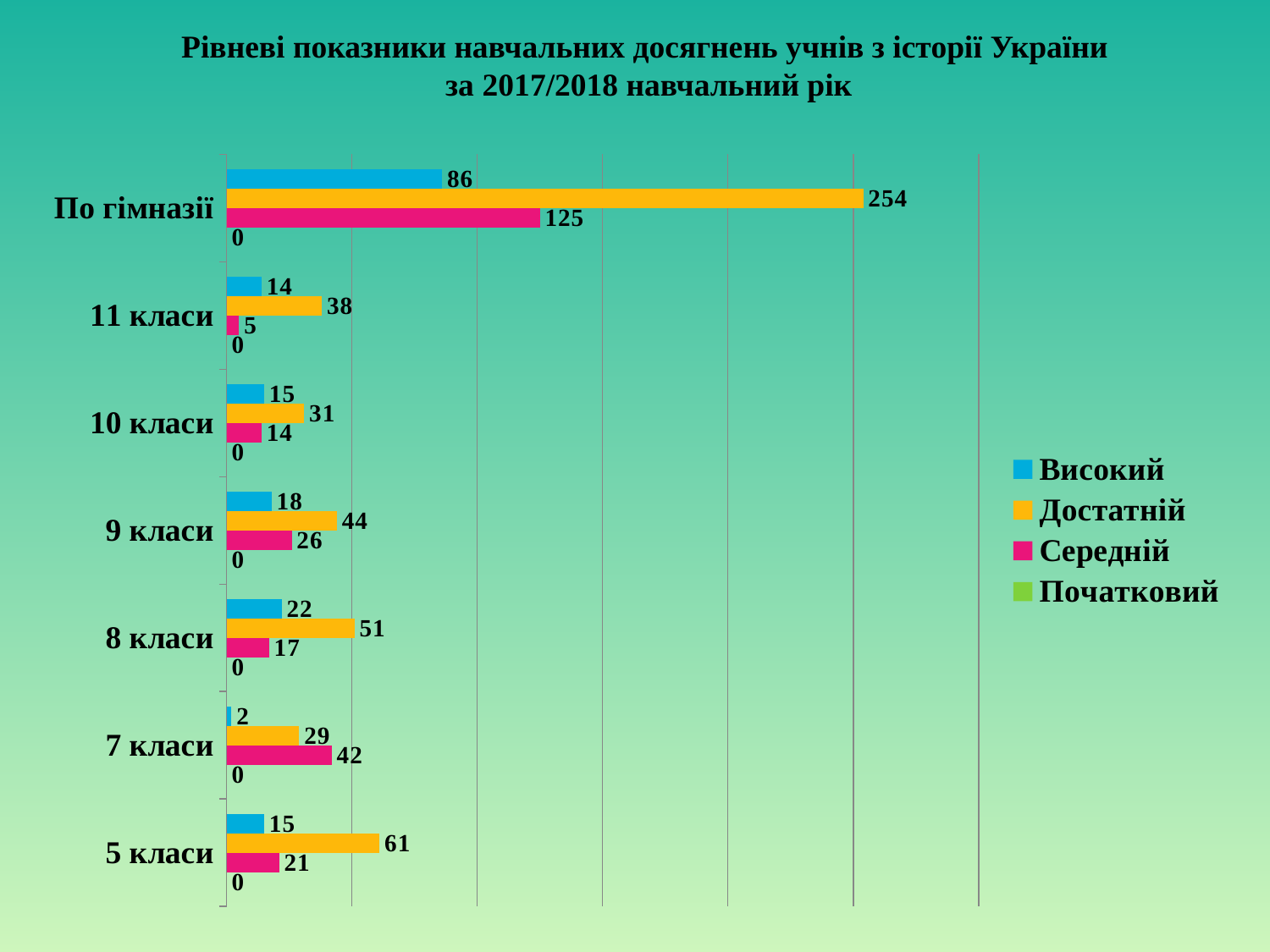
How many series does the legend list? 4 What is the value of Достатній for По гімназії? 254 What is the value of Високий for 8 класи? 22 Which colour represents the Середній series in the legend? pink How many categories are shown on the vertical axis? 7 What kind of chart is shown on the slide? bar chart Which class category has the highest Достатній value, excluding По гімназії? 5 класи What is the value of Початковий for 5 класи? 0 Which is larger for 7 класи: Достатній or Середній? Середній What is the difference between the Достатній and Середній values for По гімназії? 129 What is the value of Середній for 7 класи? 42 Which category has the lowest Високий value? 7 класи